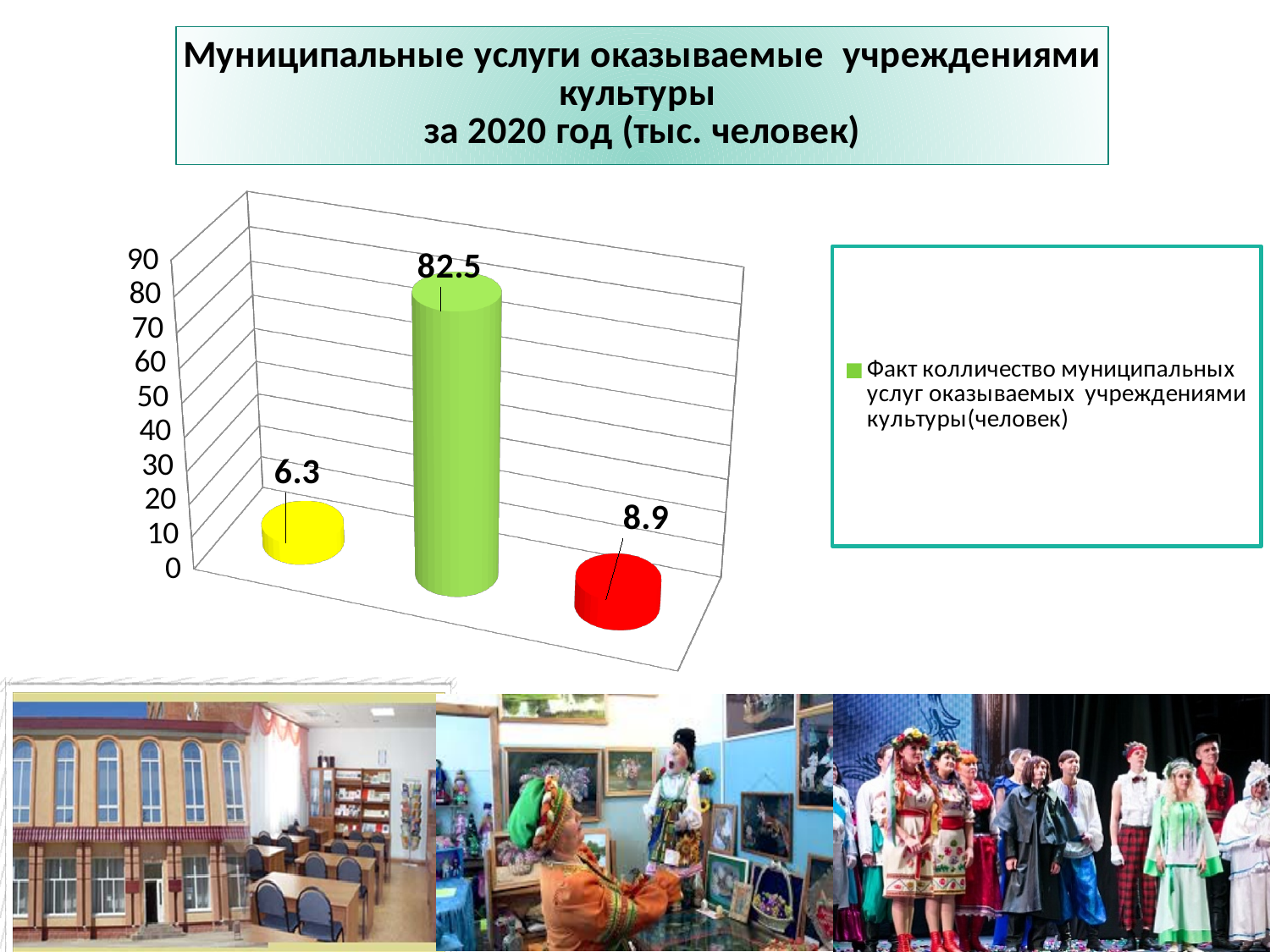
What is the value shown on the green (middle) bar? 82.5 Is the value of the green bar greater or less than 80? greater What is the difference between the green bar's value and the red bar's value? 73.6 How many series does the legend list? 1 What is the value shown on the red (right) bar? 8.9 What is the difference between the red bar's value and the yellow bar's value? 2.6 How many bars are plotted on the chart? 3 Which is larger, the value of the red bar or the value of the yellow bar? The red bar (8.9) Which bar has the highest value? The green (middle) bar, 82.5 What is the value shown on the yellow (left) bar? 6.3 Which bar has the lowest value? The yellow (left) bar, 6.3 What type of chart is shown on the slide? Bar chart